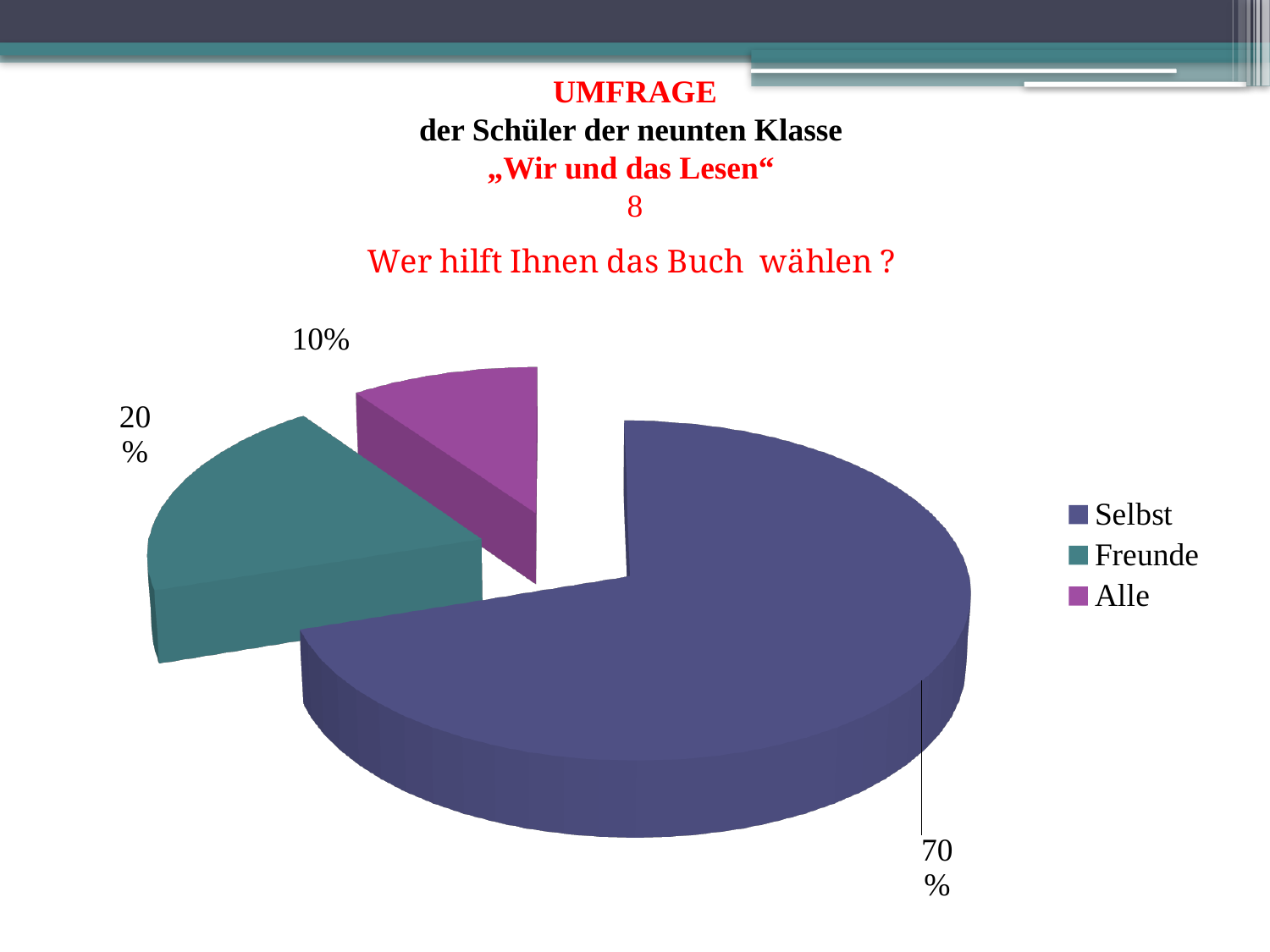
Which is larger, the share for Freunde or the share for Alle? Freunde Which colour represents Alle in the legend? purple Which category has the largest share of the pie? Selbst What is the difference between the shares for Selbst and Freunde? 50% What kind of chart is shown on the slide? pie chart What percentage is shown for Alle? 10% How many categories does the pie chart have? 3 What is the difference between the shares for Freunde and Alle? 10% What percentage is shown for Freunde? 20% Which category has the smallest share of the pie? Alle What percentage is shown for Selbst? 70% What question does the chart answer, according to the slide? Wer hilft Ihnen das Buch wählen ?